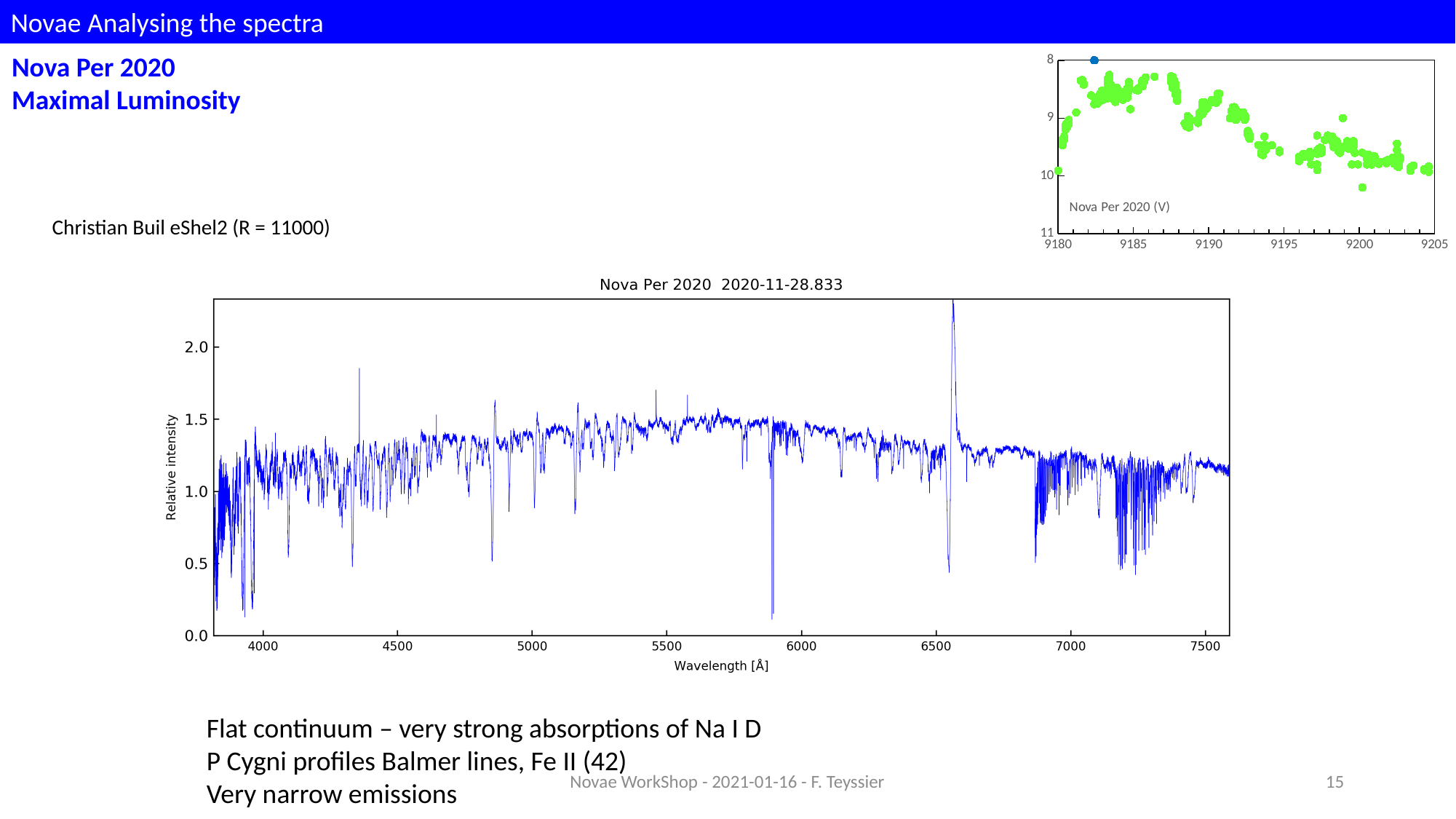
In the large spectrum chart, is the continuum level around 7500 Å greater or less than 1.5? less In the large spectrum chart, is the relative intensity at the deepest absorption near 5900 Å greater or less than 0.5? less In the large spectrum chart, is the continuum level around 5500 Å greater or less than 1.0? greater What kind of chart is the large chart titled "Nova Per 2020 2020-11-28.833"? line chart What kind of chart is the small chart in the top right labelled "Nova Per 2020 (V)"? scatter chart In the top-right light curve chart, do the plotted magnitude values become larger or smaller as the x axis increases from 9185 to 9205? larger What is the y-axis label of the large spectrum chart? Relative intensity How many data series are plotted in the large spectrum chart? 1 What is the x-axis label of the large spectrum chart? Wavelength [Å]